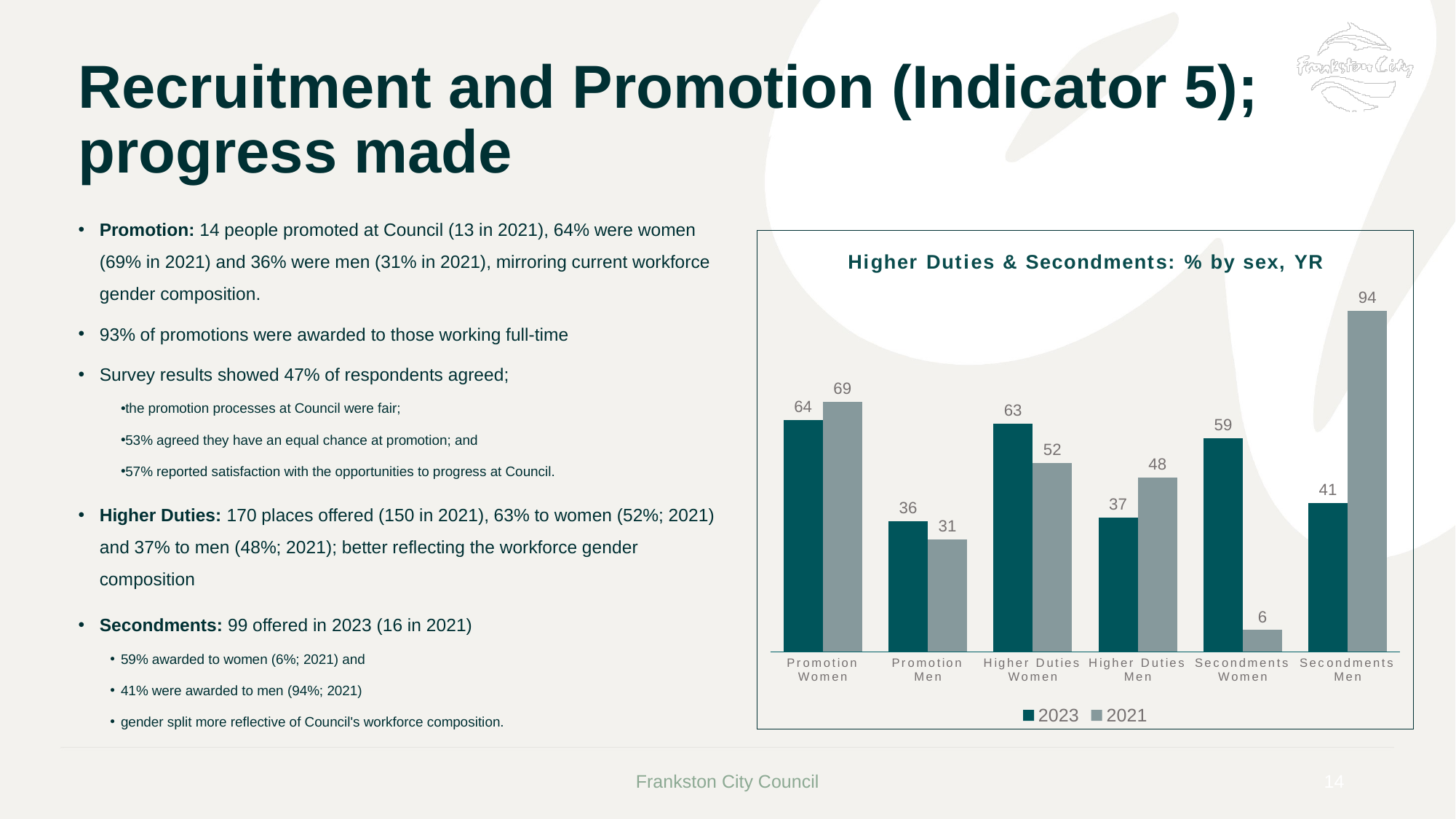
Which is larger for Higher Duties Men: the 2023 value or the 2021 value? 2021 What is the 2021 value for Promotion Men? 31 Which category has the lowest 2021 value? Secondments Women What is the title of the chart? Higher Duties & Secondments: % by sex, YR Which category has the highest 2021 value? Secondments Men How many categories are shown on the x axis? 6 How many series does the legend list? 2 What is the 2023 value for Higher Duties Women? 63 Which category has the highest 2023 value? Promotion Women What kind of chart is shown on the slide? Bar chart What is the 2021 value for Secondments Men? 94 What is the difference between the 2023 and 2021 values for Secondments Women? 53